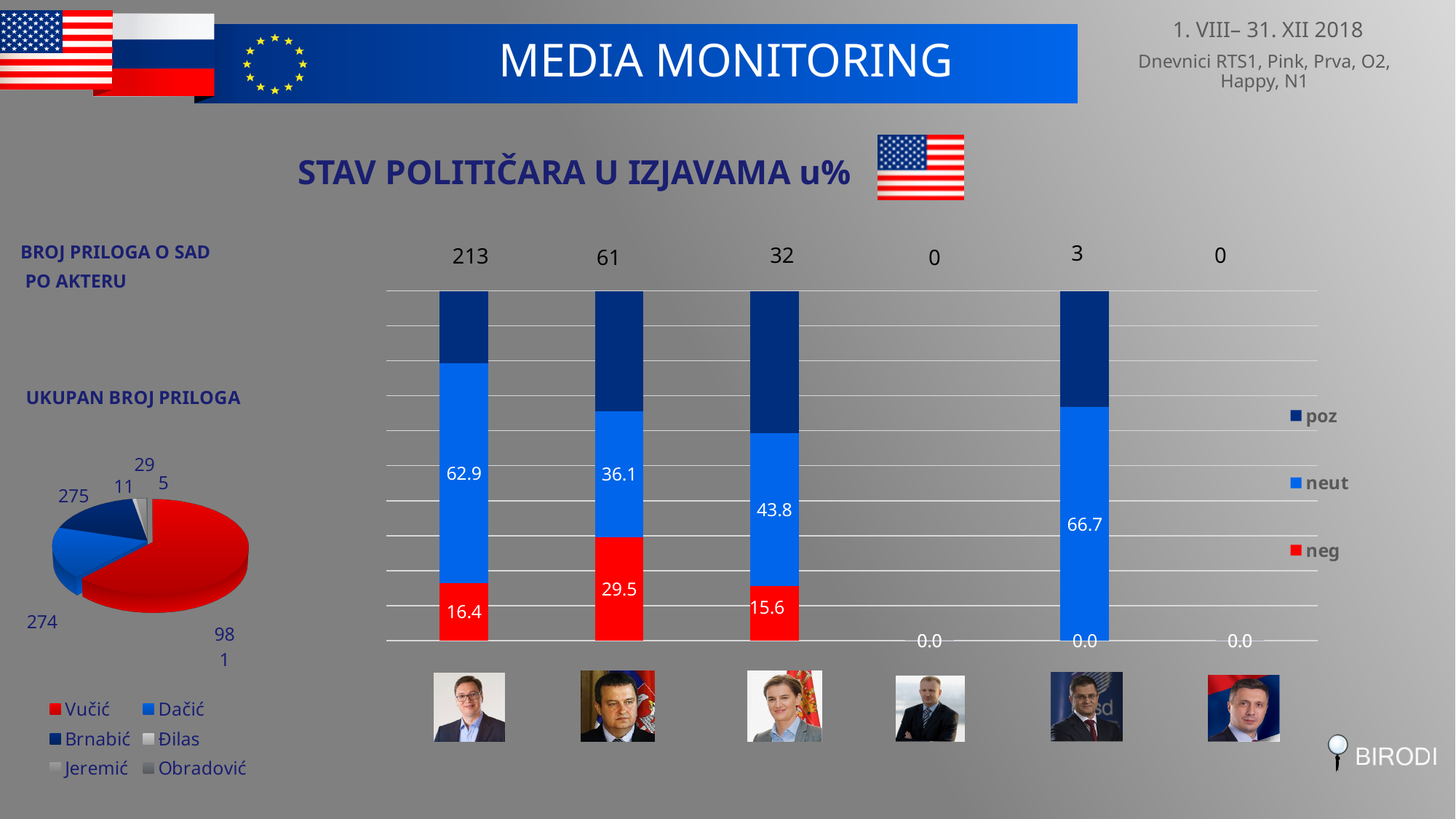
In the 'STAV POLITIČARA U IZJAVAMA u%' chart, what is the 'neg' value for the second bar? 29.5 In the 'STAV POLITIČARA U IZJAVAMA u%' chart, which is larger: the 'neg' value of the first bar or of the third bar? the first bar (16.4) What kind of chart is the chart titled 'STAV POLITIČARA U IZJAVAMA u%'? stacked bar chart In the 'STAV POLITIČARA U IZJAVAMA u%' chart, what is the 'neut' value for the first (leftmost) bar? 62.9 How many series does the legend of the 'STAV POLITIČARA U IZJAVAMA u%' chart list? 3 In the 'STAV POLITIČARA U IZJAVAMA u%' chart, what are the legend entries? poz, neut, neg In the pie chart 'UKUPAN BROJ PRILOGA', which politician has the largest slice? Vučić In the 'STAV POLITIČARA U IZJAVAMA u%' chart, what is the 'neut' value for the fifth bar? 66.7 In the 'STAV POLITIČARA U IZJAVAMA u%' chart, what is the 'neut' value for the third bar? 43.8 How many bars (politicians) are shown in the 'STAV POLITIČARA U IZJAVAMA u%' chart? 6 In the 'STAV POLITIČARA U IZJAVAMA u%' chart, what is the difference between the 'neut' values of the first and second bars? 26.8 In the 'STAV POLITIČARA U IZJAVAMA u%' chart, which bar has the highest 'neg' value? the second bar (29.5)